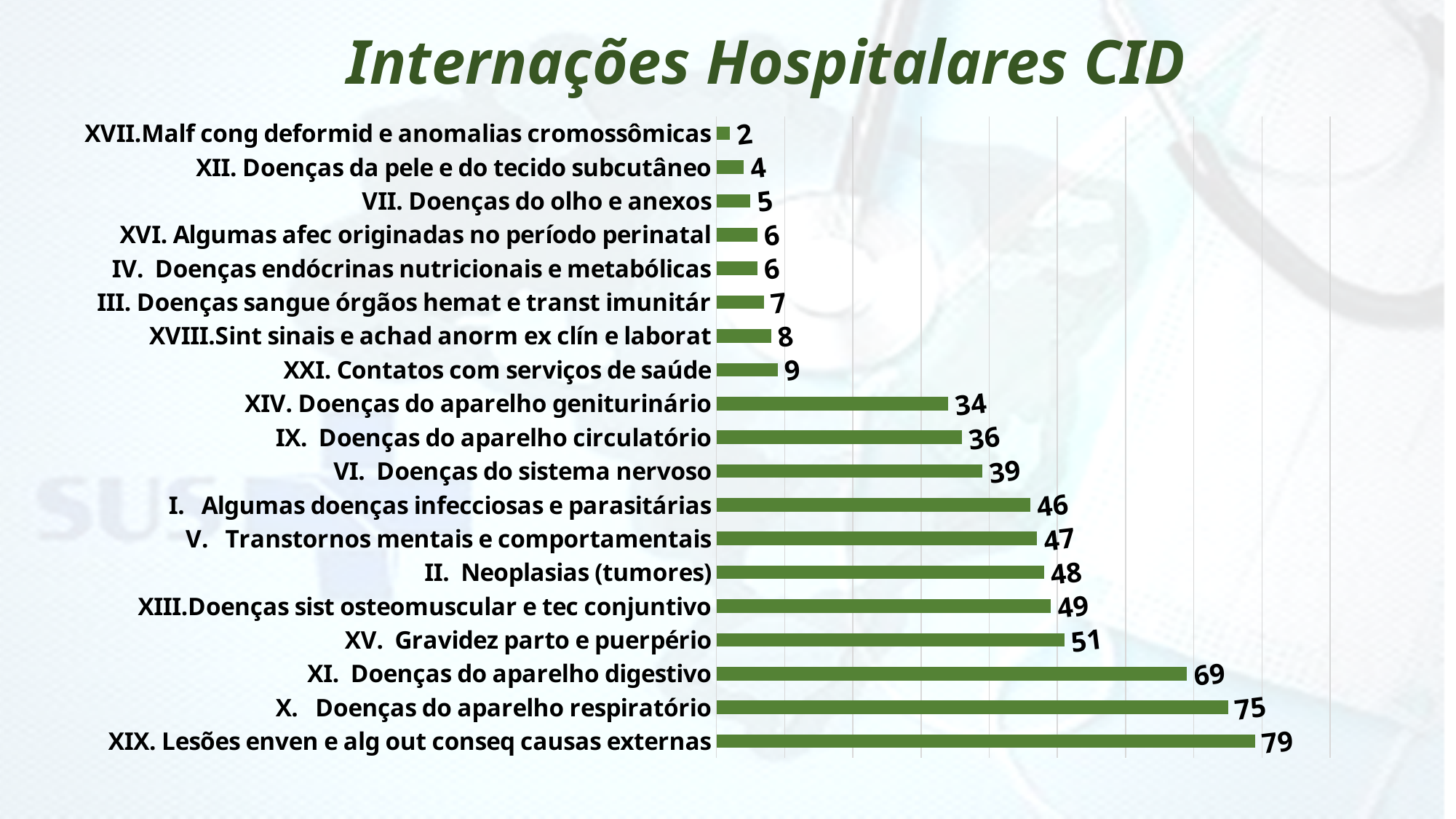
What is the difference between the values for II. Neoplasias (tumores) and XII. Doenças da pele e do tecido subcutâneo? 44 What is the value for XI. Doenças do aparelho digestivo? 69 What kind of chart is shown on the slide? Bar chart What is the title of the chart? Internações Hospitalares CID What is the value for XXI. Contatos com serviços de saúde? 9 Which category has the lowest value? XVII.Malf cong deformid e anomalias cromossômicas Which category has the highest value? XIX. Lesões enven e alg out conseq causas externas What is the value for XIV. Doenças do aparelho geniturinário? 34 Which is larger: the value for XV. Gravidez parto e puerpério or the value for VI. Doenças do sistema nervoso? XV. Gravidez parto e puerpério What is the value for XIX. Lesões enven e alg out conseq causas externas? 79 How many categories are shown in the chart? 19 What is the difference between the values for X. Doenças do aparelho respiratório and XI. Doenças do aparelho digestivo? 6